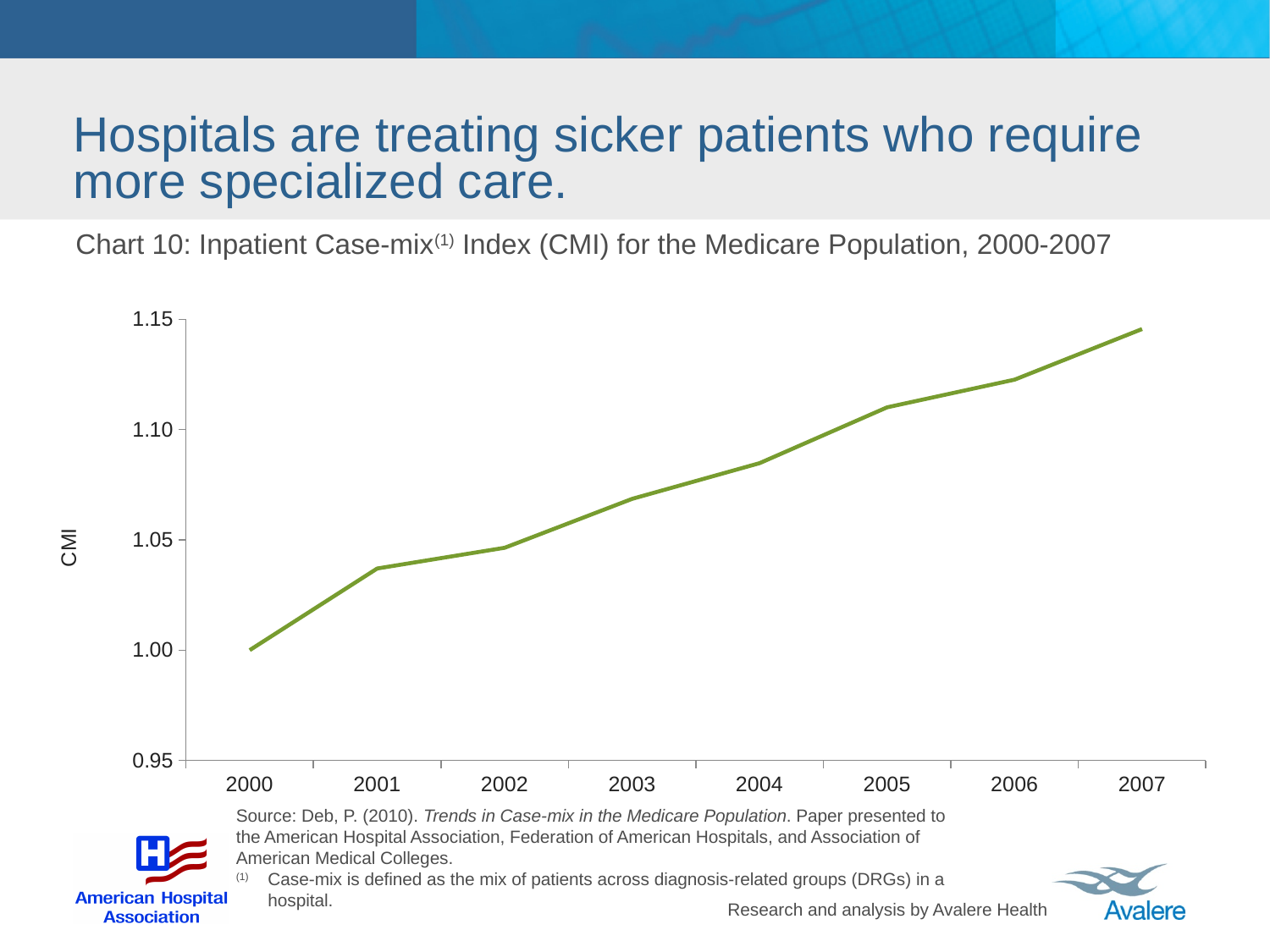
Is the CMI value for 2003 greater or less than 1.05? greater Is the CMI value for 2007 greater or less than 1.10? greater What is the label on the y axis of the chart? CMI How many years are plotted on the x axis of the chart? 8 What kind of chart is shown on the slide? line chart Is the CMI value for 2001 greater or less than 1.05? less Which year has the larger CMI value, 2003 or 2006? 2006 What is the CMI value for 2000? 1.00 Which year has the lowest CMI value in the chart? 2000 Do the CMI values rise or fall from 2000 to 2007? rise Which year has the highest CMI value in the chart? 2007